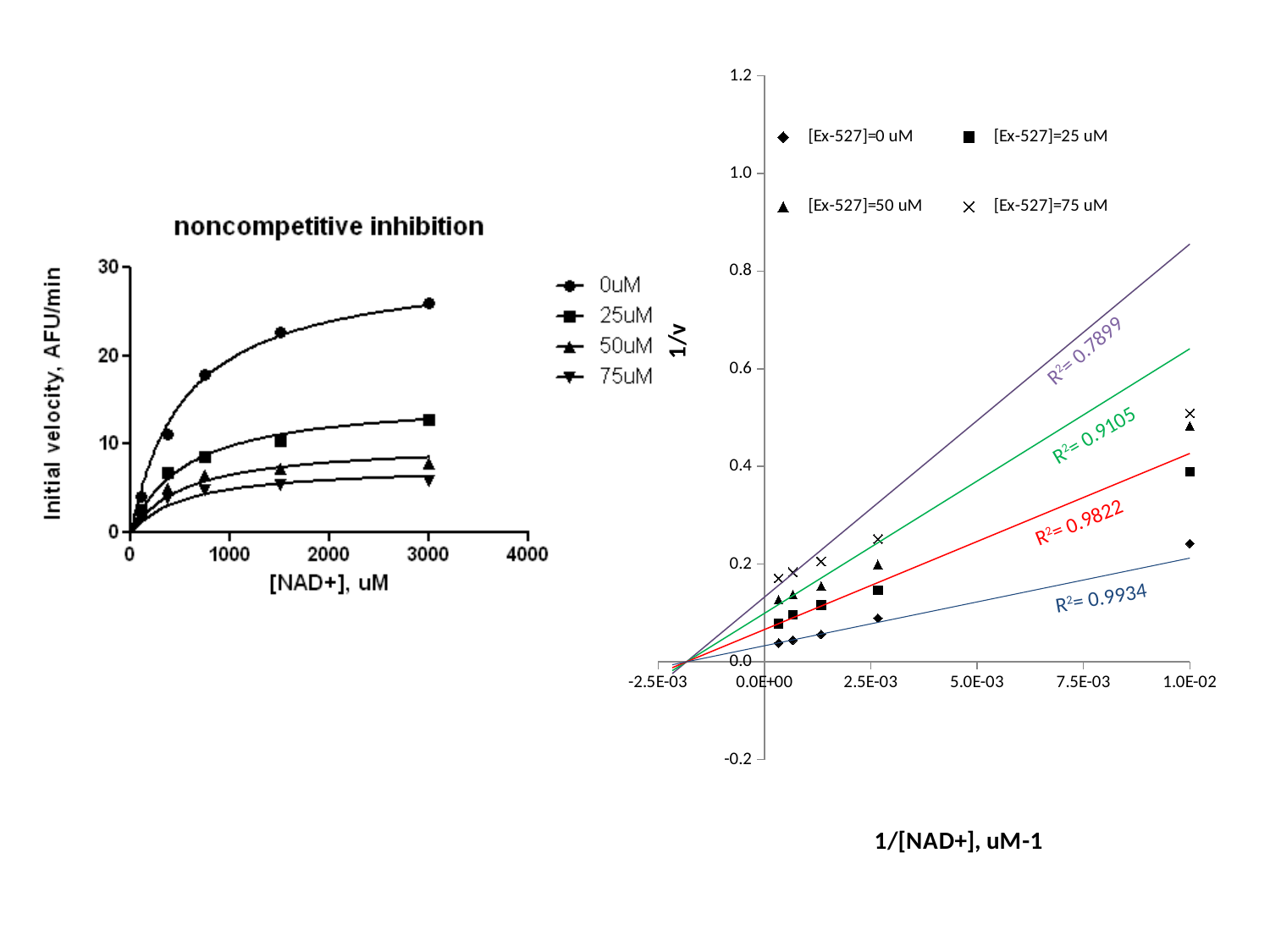
In the left chart, is the initial velocity for the 75uM series at [NAD+] = 3000 uM greater or less than 10? less In the right chart, is the 1/v value for [Ex-527]=0 uM at 1/[NAD+] = 1.0E-02 greater or less than 0.4? less In the right chart, what is the difference between the highest R² value (0.9934) and the lowest R² value (0.7899)? 0.2035 In the left chart, which series has the highest initial velocity at [NAD+] = 3000 uM? 0uM In the right chart, what is the highest R² value shown? 0.9934 What is the title of the chart on the left? noncompetitive inhibition In the right chart, what is the lowest R² value shown? 0.7899 In the left chart, how many series does the legend list? 4 In the right chart, how many series does the legend list? 4 In the left chart, which series has the lowest initial velocity at [NAD+] = 3000 uM? 75uM In the left chart, is the initial velocity for the 0uM series at [NAD+] = 3000 uM greater or less than 20? greater In the left chart, do the initial velocity values rise or fall as [NAD+] increases? rise